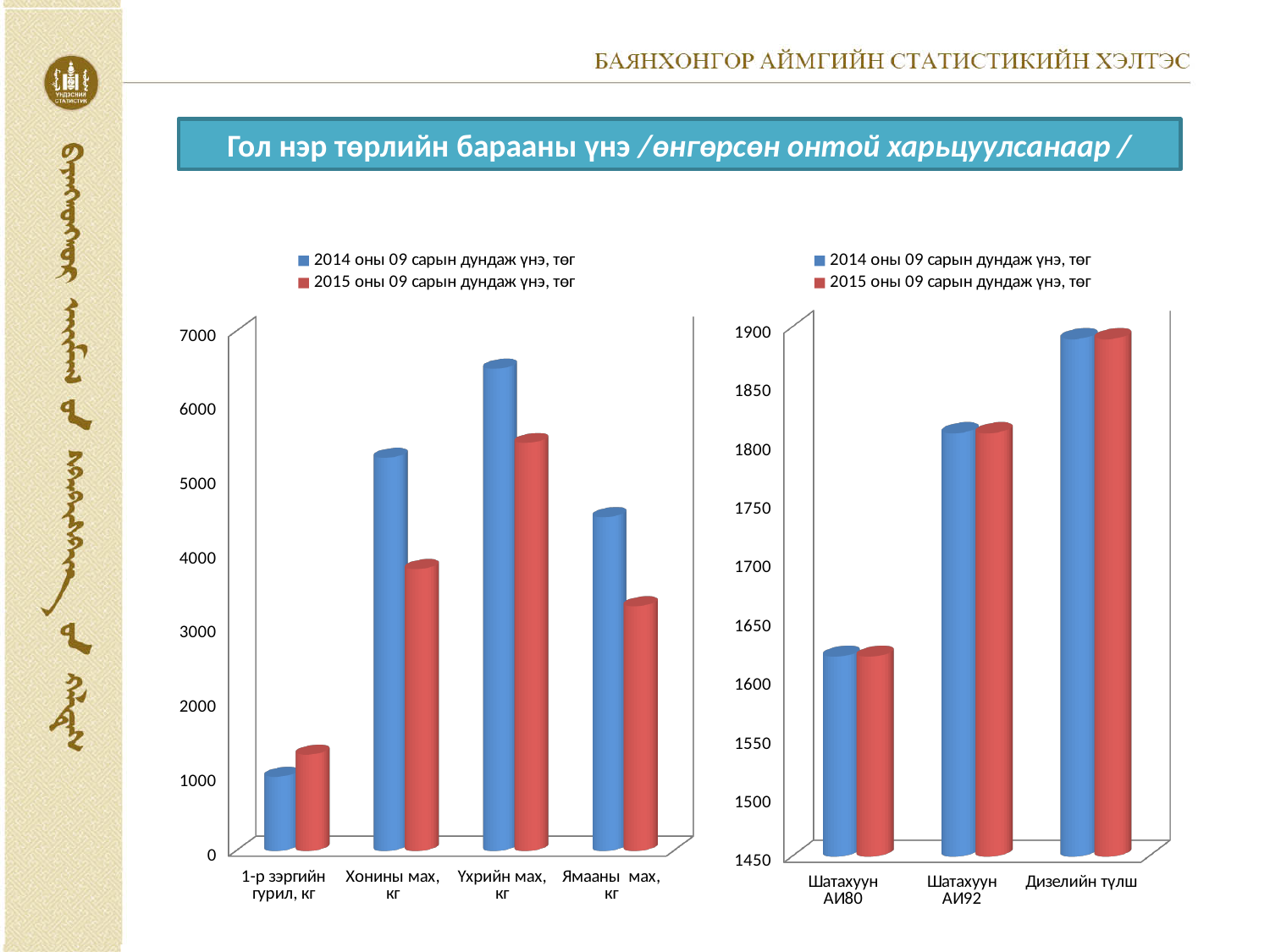
What kind of chart is the left chart on the slide? bar chart In the left chart, how many series does the legend list? 2 In the right chart, how many fuel categories are shown on the x axis? 3 In the left chart, which category has the lowest value for the series '2014 оны 09 сарын дундаж үнэ, төг'? 1-р зэргийн гурил, кг In the left chart, how many product categories are shown on the x axis? 4 In the left chart, for 'Хонины мах, кг', which series is larger: 2014 оны 09 сарын дундаж үнэ or 2015 оны 09 сарын дундаж үнэ? 2014 оны 09 сарын дундаж үнэ, төг In the left chart, which category has the highest value for the series '2014 оны 09 сарын дундаж үнэ, төг'? Үхрийн мах, кг In the left chart, for '1-р зэргийн гурил, кг', which series is larger: 2014 оны 09 сарын дундаж үнэ or 2015 оны 09 сарын дундаж үнэ? 2015 оны 09 сарын дундаж үнэ, төг In the left chart, is the 2015 value for 'Ямааны мах, кг' greater or less than 4000? less In the left chart, is the 2014 value for 'Үхрийн мах, кг' greater or less than 6000? greater In the right chart, which category has the highest value for the series '2014 оны 09 сарын дундаж үнэ, төг'? Дизелийн түлш In the right chart, is the 2014 value for 'Шатахуун АИ80' greater or less than 1650? less